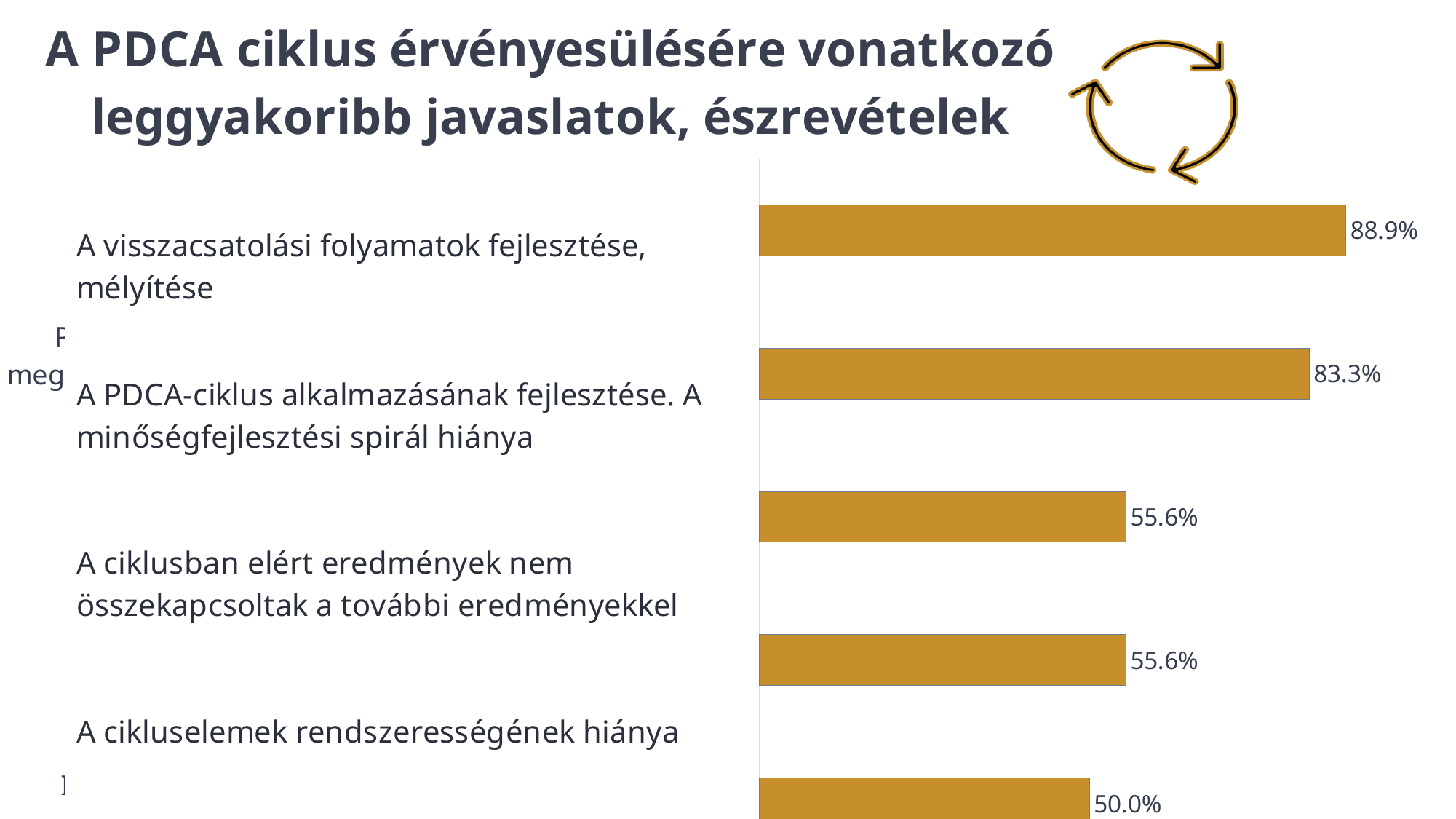
Which category has the highest value? A visszacsatolási folyamatok fejlesztése, mélyítése What is the title of the slide? A PDCA ciklus érvényesülésére vonatkozó leggyakoribb javaslatok, észrevételek What is the value for "A ciklusban elért eredmények nem összekapcsoltak a további eredményekkel"? 55.6% What is the value for "A PDCA-ciklus alkalmazásának fejlesztése. A minőségfejlesztési spirál hiánya"? 83.3% What kind of chart is shown on the slide? Bar chart What is the value shown on the bottom bar of the chart? 50.0% What is the value for "A visszacsatolási folyamatok fejlesztése, mélyítése"? 88.9% What is the difference between the values for "A visszacsatolási folyamatok fejlesztése, mélyítése" and "A PDCA-ciklus alkalmazásának fejlesztése. A minőségfejlesztési spirál hiánya"? 5.6% What is the lowest value shown in the chart? 50.0% What is the value for "A cikluselemek rendszerességének hiánya"? 55.6% How many bars are plotted in the chart? 5 Which is larger: the value for "A PDCA-ciklus alkalmazásának fejlesztése. A minőségfejlesztési spirál hiánya" or the value for "A cikluselemek rendszerességének hiánya"? A PDCA-ciklus alkalmazásának fejlesztése. A minőségfejlesztési spirál hiánya